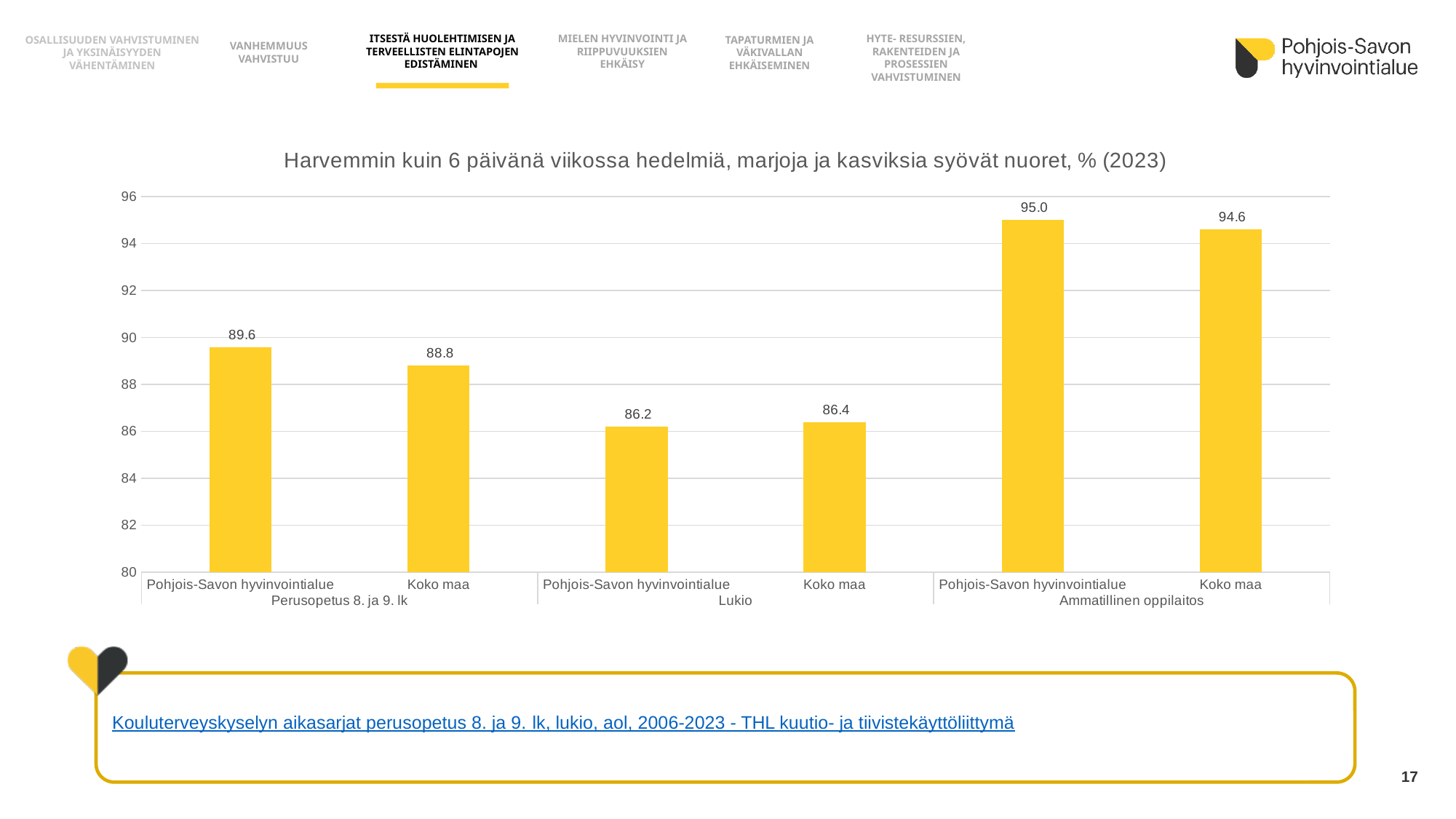
What is the value for Koko maa in the Lukio group? 86.4 Is the value for Koko maa in the Ammatillinen oppilaitos group greater or less than 94? greater What is the title of the chart? Harvemmin kuin 6 päivänä viikossa hedelmiä, marjoja ja kasviksia syövät nuoret, % (2023) What kind of chart is shown on the slide? Bar chart What is the difference between Pohjois-Savon hyvinvointialue and Koko maa in the Perusopetus 8. ja 9. lk group? 0.8 Which is larger: Koko maa in the Perusopetus 8. ja 9. lk group or Koko maa in the Lukio group? Koko maa in Perusopetus 8. ja 9. lk Which bar has the highest value? Pohjois-Savon hyvinvointialue, Ammatillinen oppilaitos Which bar has the lowest value? Pohjois-Savon hyvinvointialue, Lukio What is the value for Pohjois-Savon hyvinvointialue in the Ammatillinen oppilaitos group? 95.0 What is the difference between Pohjois-Savon hyvinvointialue and Koko maa in the Ammatillinen oppilaitos group? 0.4 What is the value for Pohjois-Savon hyvinvointialue in the Perusopetus 8. ja 9. lk group? 89.6 How many bars are plotted in the chart? 6